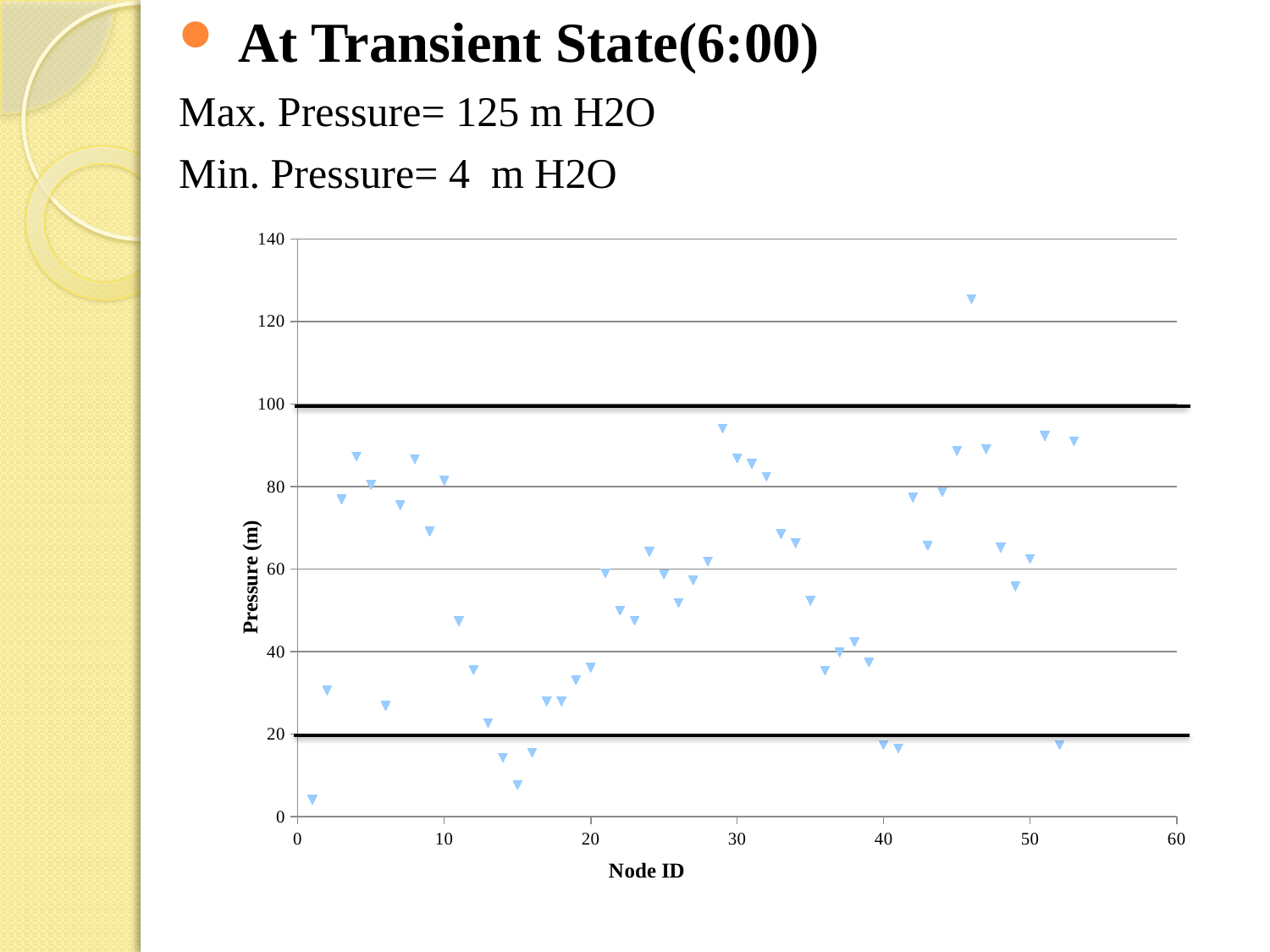
Which has the higher pressure, Node ID 29 or Node ID 15? Node ID 29 What kind of chart is shown on the slide? Scatter chart Is the pressure for Node ID 46 greater or less than 120? greater Is the pressure for Node ID 1 greater or less than 20? less Is the pressure for Node ID 11 greater or less than 60? less What is the title of the vertical axis of the chart? Pressure (m) At what pressure values are the two thick horizontal lines drawn on the chart? 20 and 100 Which has the higher pressure, Node ID 46 or Node ID 1? Node ID 46 Which Node ID has the highest pressure on the chart? 46 Which Node ID has the lowest pressure on the chart? 1